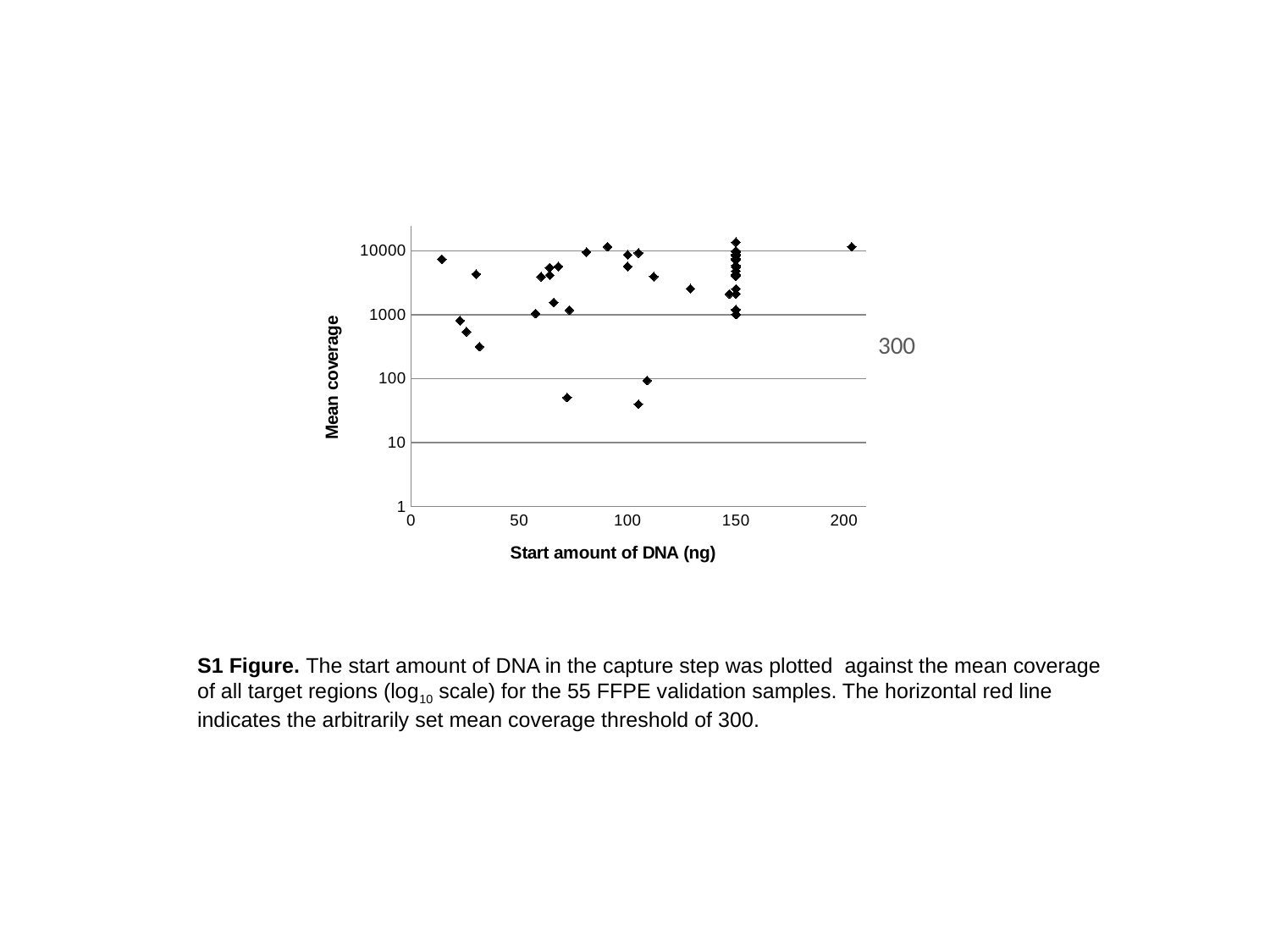
According to the caption, how many FFPE validation samples are plotted on the chart? 55 What is the title of the y axis of the chart? Mean coverage Is the mean coverage of the leftmost point (smallest start amount of DNA) greater or less than 1000? greater At which start amount of DNA are the most points clustered on the chart? 150 ng Is the lowest mean coverage among the points at 150 ng greater or less than 100? greater Is the mean coverage of the point with the largest start amount of DNA (around 200 ng) greater or less than 1000? greater What is the title of the x axis of the chart? Start amount of DNA (ng) What kind of chart is shown on the slide? Scatter chart